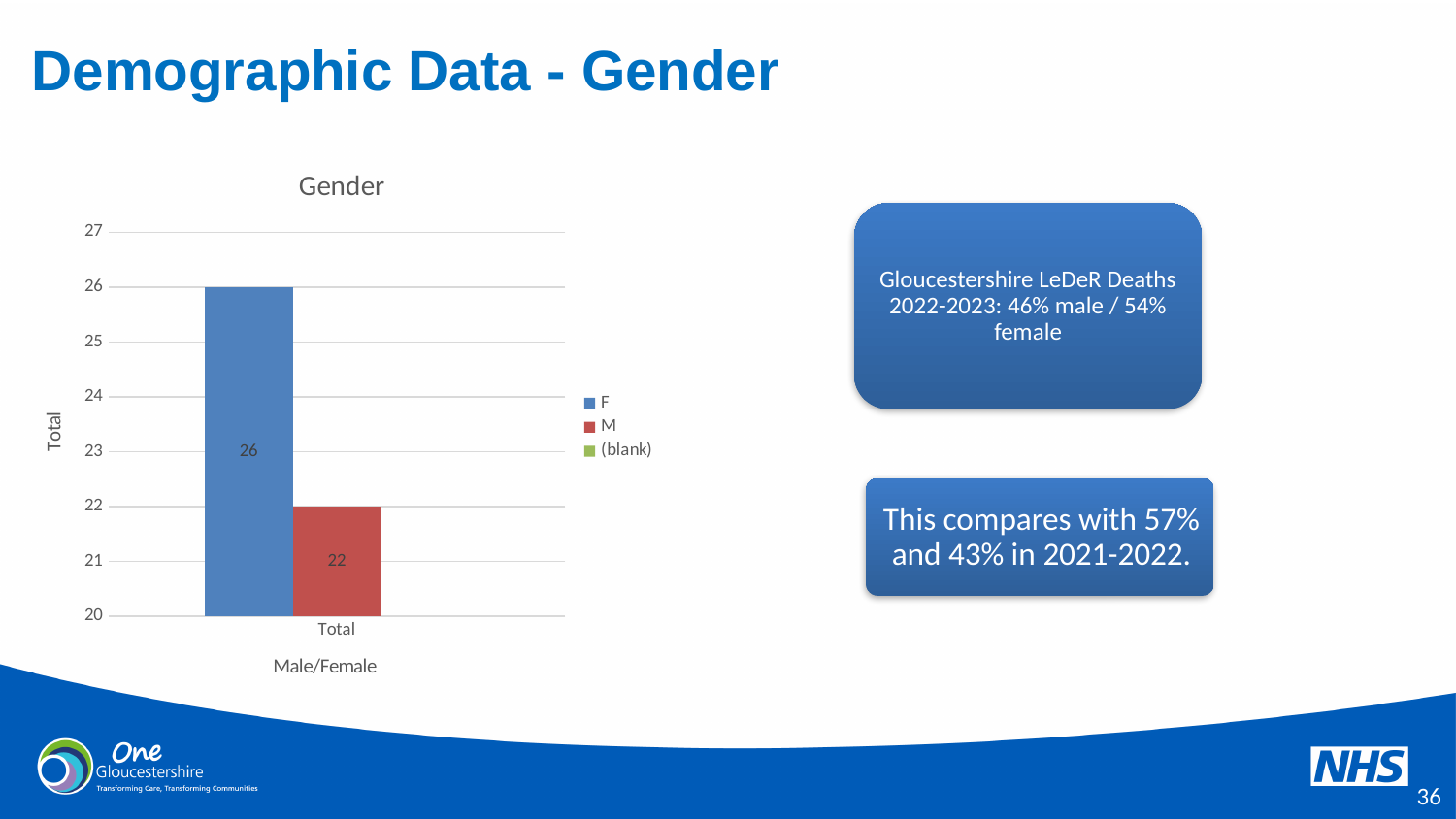
Which series has the higher value in the Gender chart, F or M? F What is the value for M in the Gender chart? 22 What kind of chart is the Gender chart? bar chart What is the label on the vertical axis of the Gender chart? Total How many series does the legend of the Gender chart list? 3 What is the value for F in the Gender chart? 26 What is the title of the chart on the slide? Gender Is the value for M in the Gender chart greater or less than 24? less Is the value for F in the Gender chart greater or less than 25? greater How many categories are shown on the x axis of the Gender chart? 1 Which series has the lowest plotted value in the Gender chart? M What is the difference between the F and M values in the Gender chart? 4